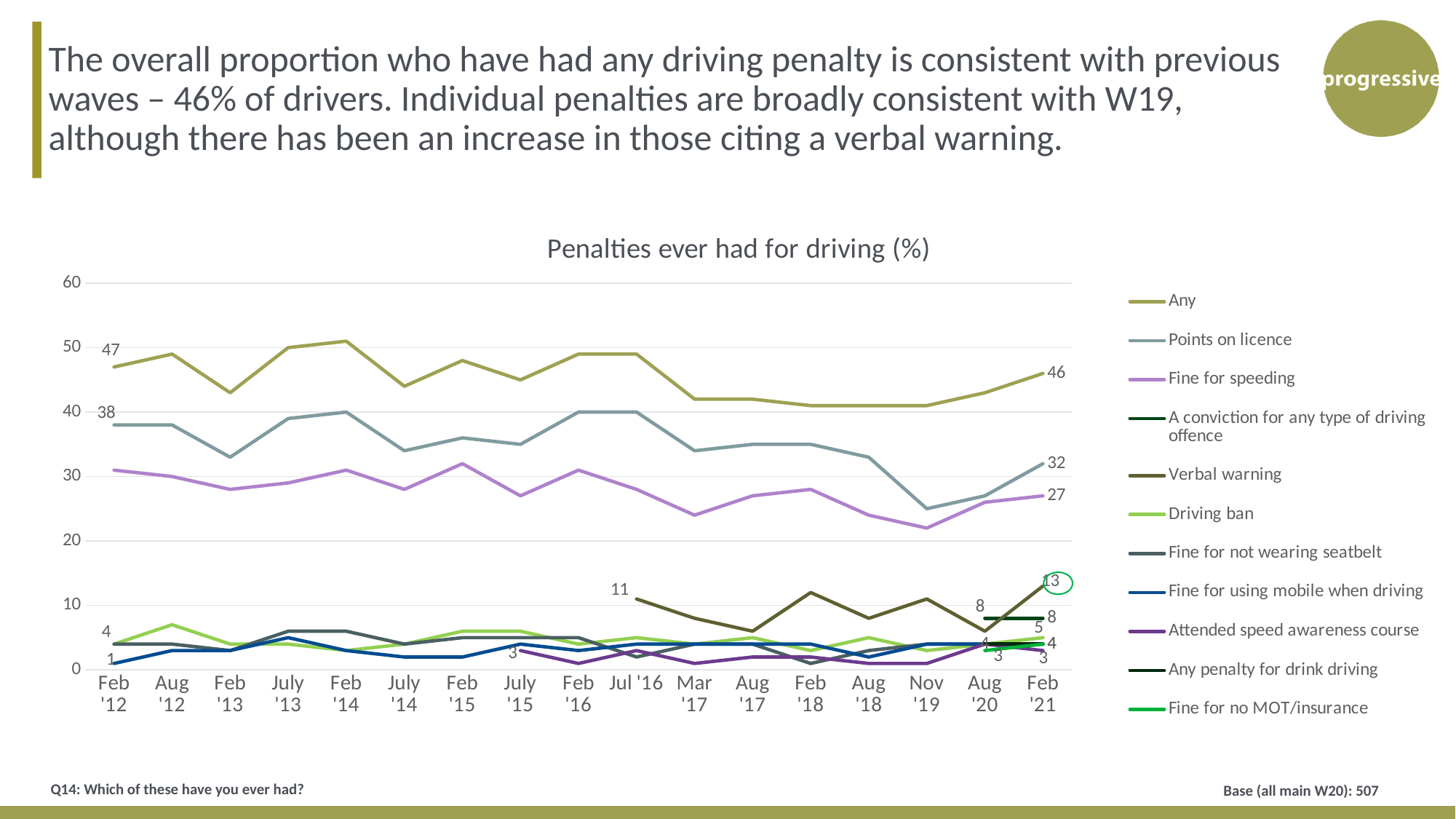
Which series has the highest value at Feb '21? Any How many series does the legend list? 11 By how much did Points on licence fall between Feb '12 and Feb '21? 6 What is the value for Points on licence at Feb '21? 32 What is the value for the Any series at Feb '12? 47 What is the value for the Any series at Feb '21? 46 What is the value for Fine for speeding at Feb '21? 27 What is the circled value for Verbal warning at Feb '21? 13 What type of chart is shown on the slide? Line chart What is the value for Verbal warning at Jul '16? 11 Is the value for Fine for speeding at Nov '19 greater or less than 30? less How many time points are shown on the x axis? 17